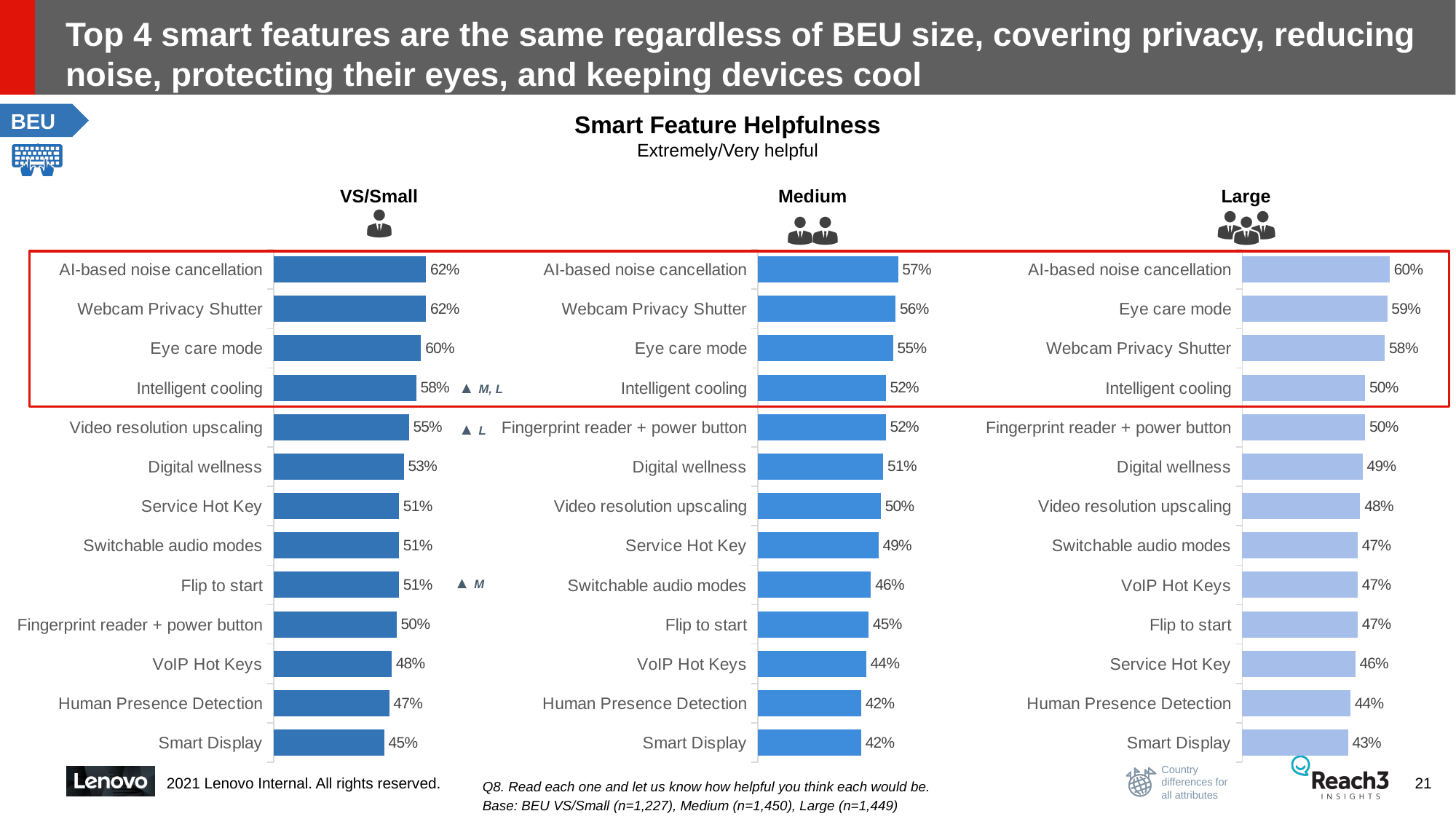
In the Medium chart, what is the difference between Webcam Privacy Shutter and Intelligent cooling? 4% Which is larger: Intelligent cooling in the VS/Small chart or Intelligent cooling in the Large chart? VS/Small In the VS/Small chart, which feature has the lowest value? Smart Display In the Large chart, which is larger: Eye care mode or Webcam Privacy Shutter? Eye care mode In the VS/Small chart, what is the value for Eye care mode? 60% What kind of chart is used for the VS/Small data? Bar chart In the Large chart, what is the difference between AI-based noise cancellation and Smart Display? 17% How many features are listed in the Large chart? 13 In the Medium chart, which feature has the highest value? AI-based noise cancellation What is the title of the chart on the slide? Smart Feature Helpfulness In the Medium chart, what is the value for Fingerprint reader + power button? 52% In the Large chart, what is the value for Human Presence Detection? 44%